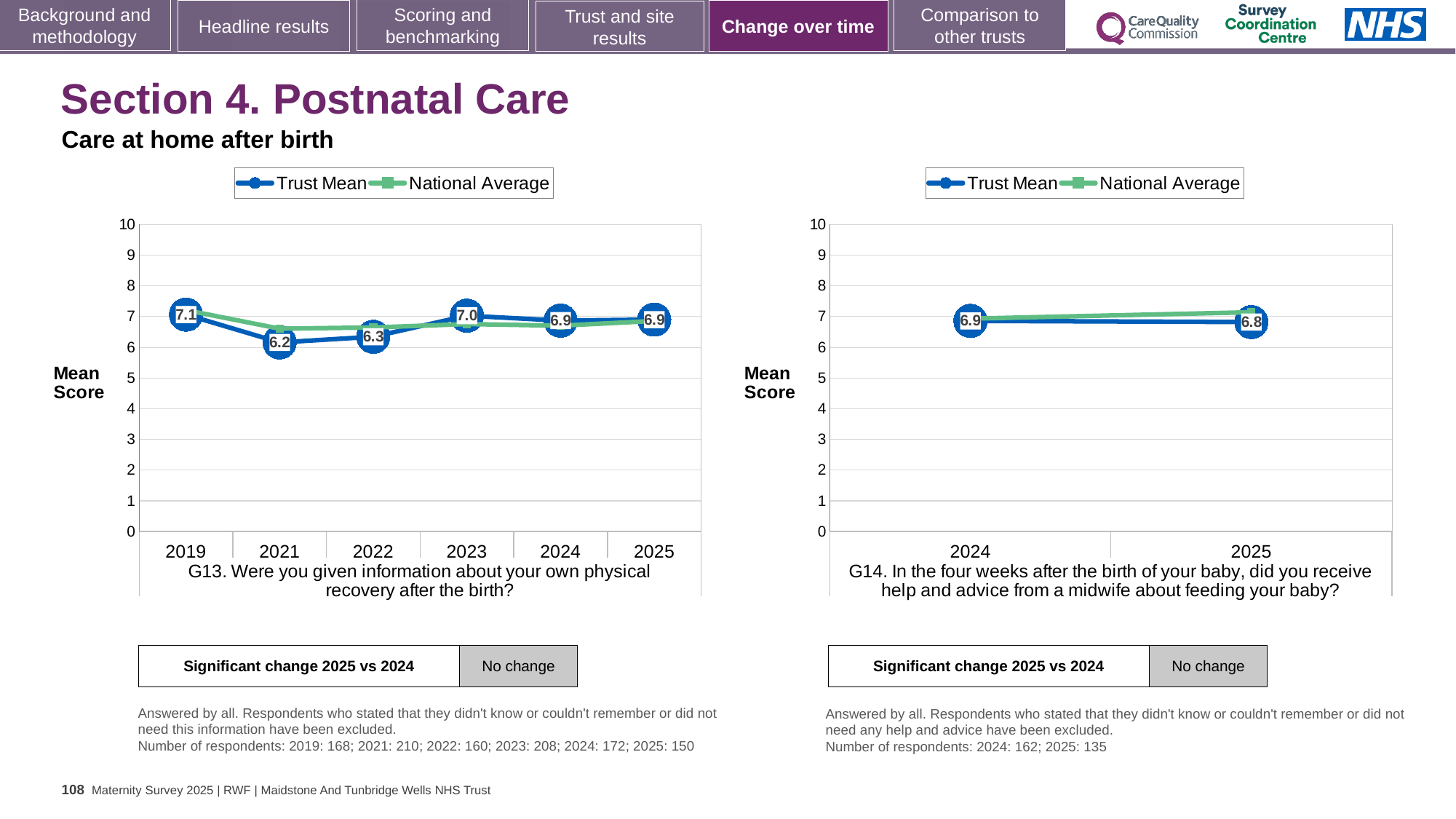
In the G13 chart on the left, is the National Average value for 2021 greater or less than 6? greater How many series does the legend of the G14 chart on the right list? 2 In the G13 chart on the left, which year has the highest Trust Mean score? 2019 In the G13 chart on the left, what is the Trust Mean score for 2021? 6.2 In the G13 chart on the left, which year has the lowest Trust Mean score? 2021 In the G14 chart on the right, does the Trust Mean rise or fall from 2024 to 2025? Fall How many years are shown on the x axis of the G13 chart on the left? 6 In the G14 chart on the right, what is the Trust Mean score for 2025? 6.8 In the G14 chart on the right, which year has the larger Trust Mean score, 2024 or 2025? 2024 What type of chart is the G13 chart on the left? Line chart In the G13 chart on the left, what is the difference between the Trust Mean scores for 2019 and 2021? 0.9 In the G13 chart on the left, what is the Trust Mean score for 2019? 7.1